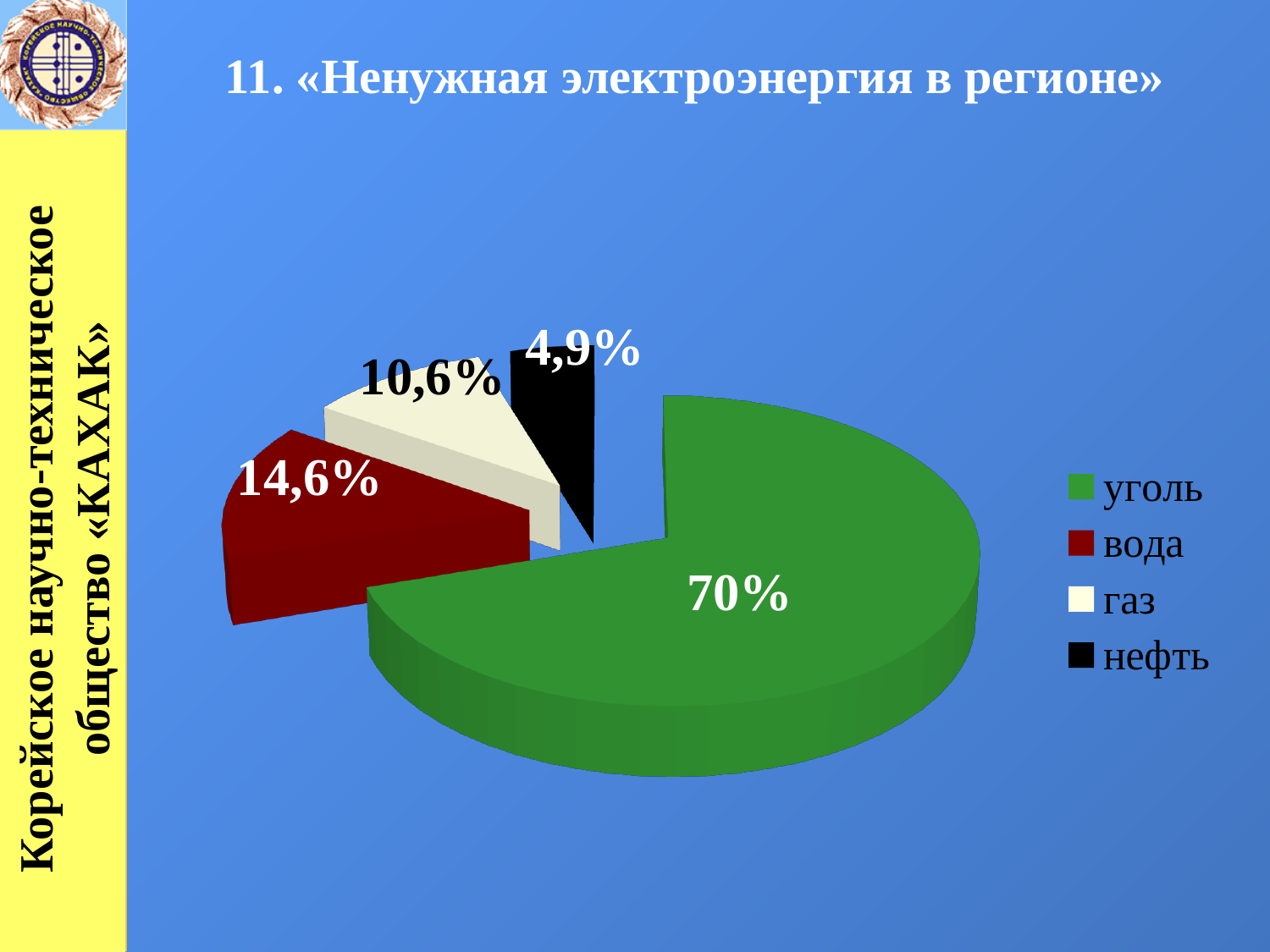
How many categories does the pie chart have? 4 Which category has the smallest slice of the pie? нефть What is the title of the slide containing the chart? 11. «Ненужная электроэнергия в регионе» What is the value shown for вода (water)? 14,6% What is the value shown for нефть (oil)? 4,9% What colour is the slice for уголь? green What kind of chart is shown on the slide? pie chart What is the value shown for газ (gas)? 10,6% Which category has the largest slice of the pie? уголь Which is larger, the slice for вода or the slice for газ? вода What is the difference between the values for вода and газ? 4% What share of the pie does уголь (coal) have? 70%